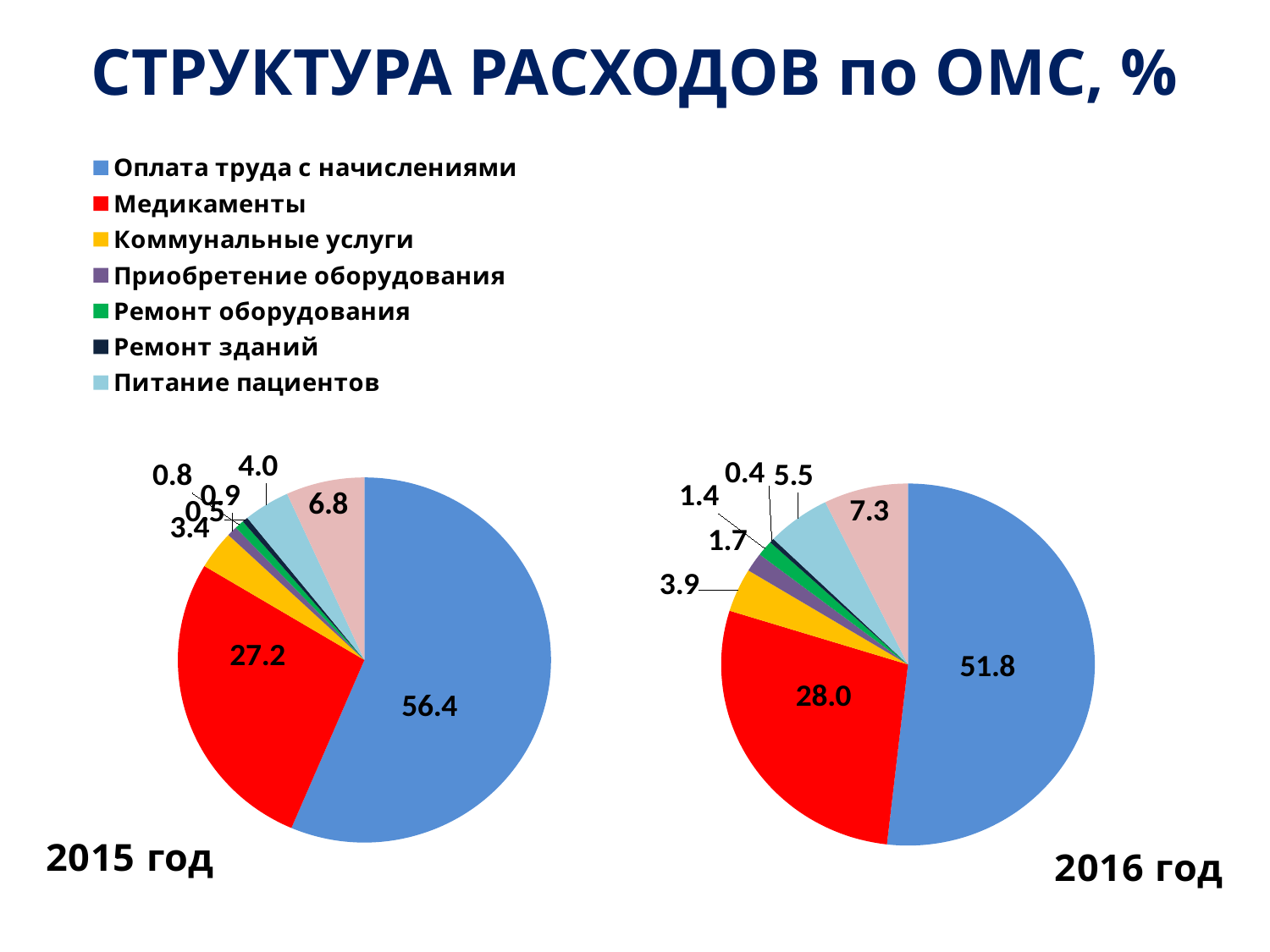
How many slices does the 2016 год pie chart have? 8 In the 2016 год pie chart, which category has the smallest slice? Ремонт зданий Is the Медикаменты value larger in the 2015 год chart or the 2016 год chart? 2016 год How many entries does the legend list? 7 In the 2015 год pie chart, what is the value for Коммунальные услуги? 3.4 In the 2015 год pie chart, what is the value for Оплата труда с начислениями? 56.4 In the 2016 год pie chart, what is the value for Медикаменты? 28.0 What is the difference between the Оплата труда с начислениями value in the 2015 год chart and in the 2016 год chart? 4.6 What type of chart is used on this slide? Pie chart In the 2015 год pie chart, which category has the largest slice? Оплата труда с начислениями In the 2016 год pie chart, what is the value for Питание пациентов? 5.5 In the 2016 год pie chart, what is the value for Коммунальные услуги? 3.9